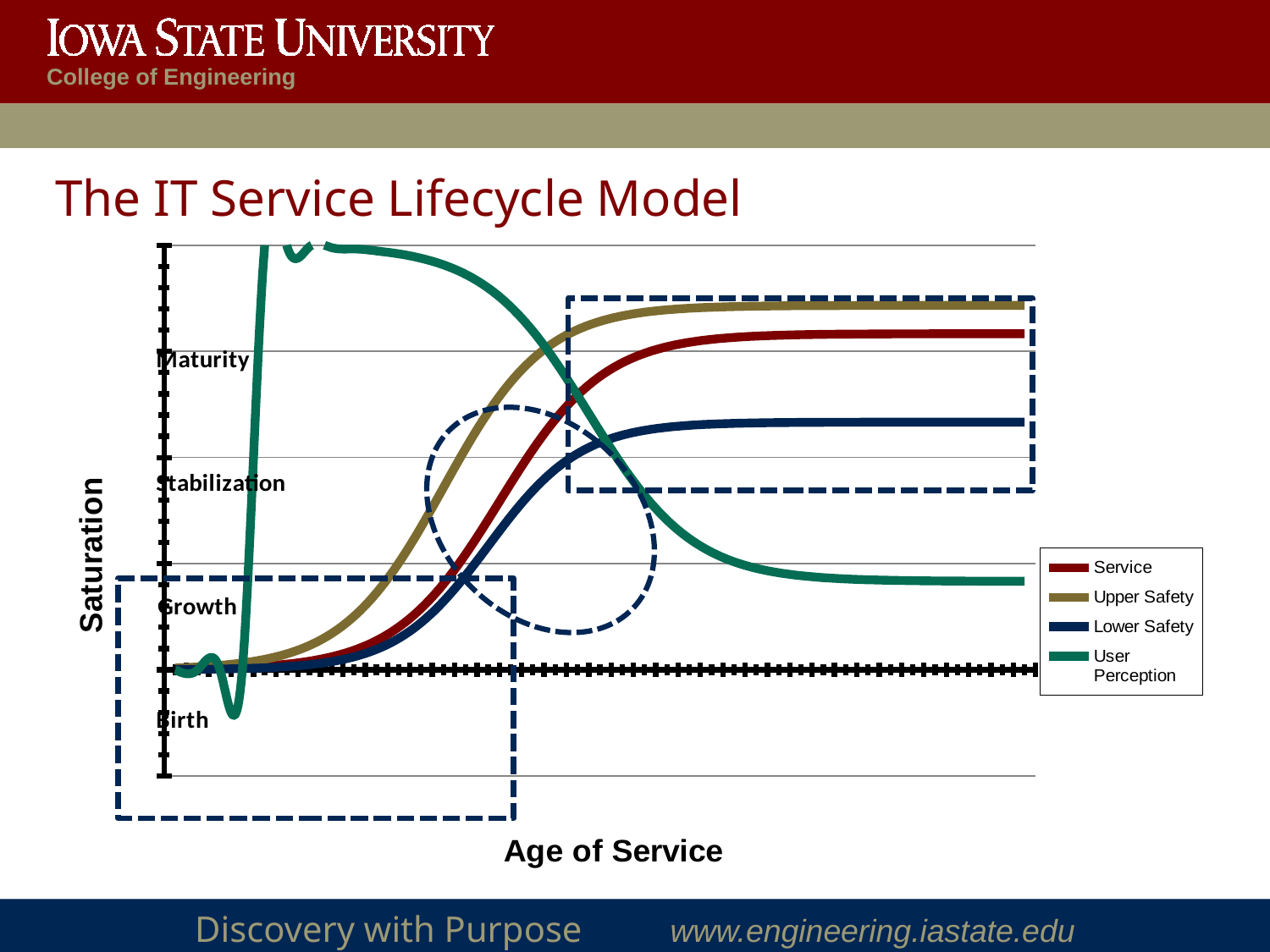
How many lifecycle stage labels are shown along the vertical axis? 4 Does the Service line rise or fall as Age of Service increases? rise At the right end of the chart, which of the four series has the lowest value? User Perception Which series is plotted in green? User Perception Does the User Perception line rise or fall over the right half of the chart? fall At the right end of the chart, which series has the highest value: Service, Upper Safety or Lower Safety? Upper Safety How many series does the legend list? 4 What is the label of the horizontal axis? Age of Service Which series is plotted in dark red? Service At the right end of the chart, which is larger: Service or Lower Safety? Service What is the title of the chart on the slide? The IT Service Lifecycle Model What kind of chart is shown on the slide? line chart